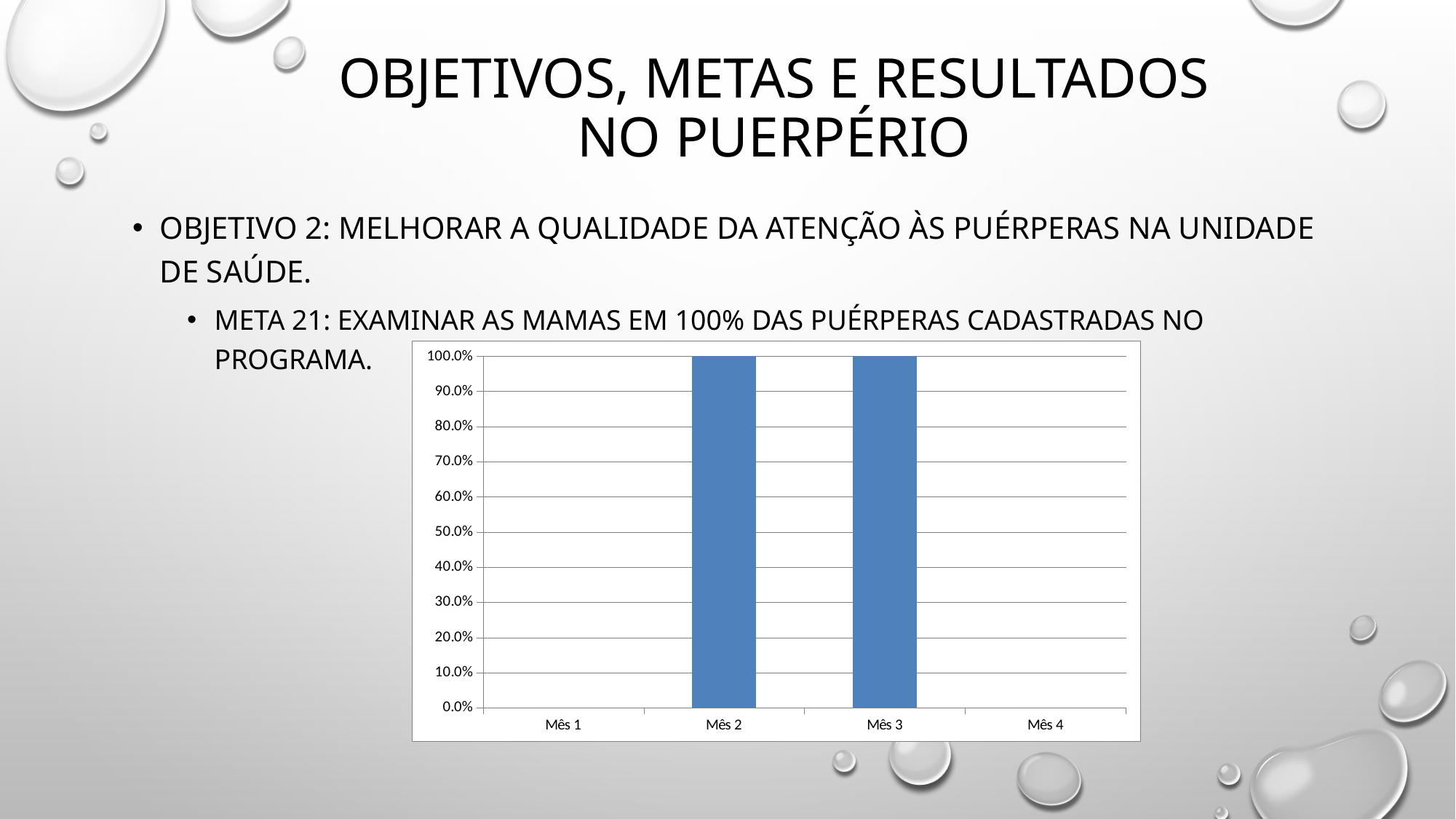
What is the value for Mês 2 in the chart? 100.0% Which is larger in the chart, the value for Mês 2 or the value for Mês 1? Mês 2 What is the value for Mês 1 in the chart? 0.0% Which months reach the highest value in the chart? Mês 2 and Mês 3 What kind of chart is shown on the slide? Bar chart What is the difference between the values for Mês 2 and Mês 4 in the chart? 100.0% What is the highest value shown on the y axis of the chart? 100.0% What is the value for Mês 4 in the chart? 0.0% What is the value for Mês 3 in the chart? 100.0% How many categories are shown on the x axis of the chart? 4 Is the value for Mês 3 greater or less than 50.0%? greater What colour are the bars in the chart? Blue